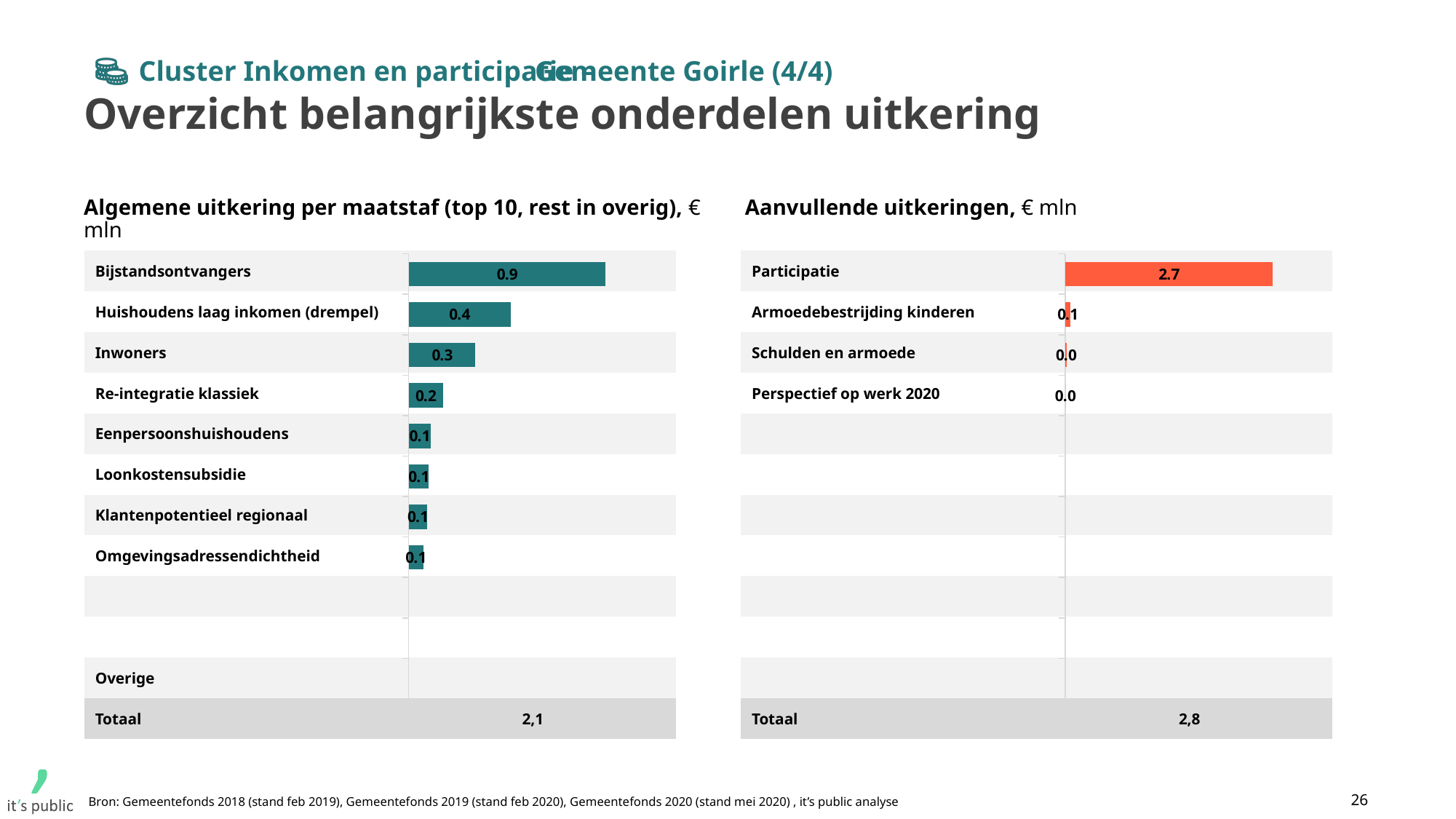
In the 'Algemene uitkering per maatstaf' chart, what is the value for Bijstandsontvangers? 0.9 In the 'Aanvullende uitkeringen' chart, what is the value for Participatie? 2.7 In the 'Aanvullende uitkeringen' chart, how many categories have a bar or value shown? 4 In the 'Algemene uitkering per maatstaf' chart, what is the Totaal value shown? 2,1 In the 'Algemene uitkering per maatstaf' chart, what is the value for Inwoners? 0.3 In the 'Algemene uitkering per maatstaf' chart, which is larger: Huishoudens laag inkomen (drempel) or Re-integratie klassiek? Huishoudens laag inkomen (drempel) What kind of chart is the 'Aanvullende uitkeringen' chart? Bar chart In the 'Aanvullende uitkeringen' chart, what is the value for Armoedebestrijding kinderen? 0.1 In the 'Algemene uitkering per maatstaf' chart, what is the value for Huishoudens laag inkomen (drempel)? 0.4 In the 'Algemene uitkering per maatstaf' chart, which category has the highest value? Bijstandsontvangers In the 'Aanvullende uitkeringen' chart, what is the Totaal value shown? 2,8 In the 'Algemene uitkering per maatstaf' chart, what is the difference between Bijstandsontvangers and Inwoners? 0.6